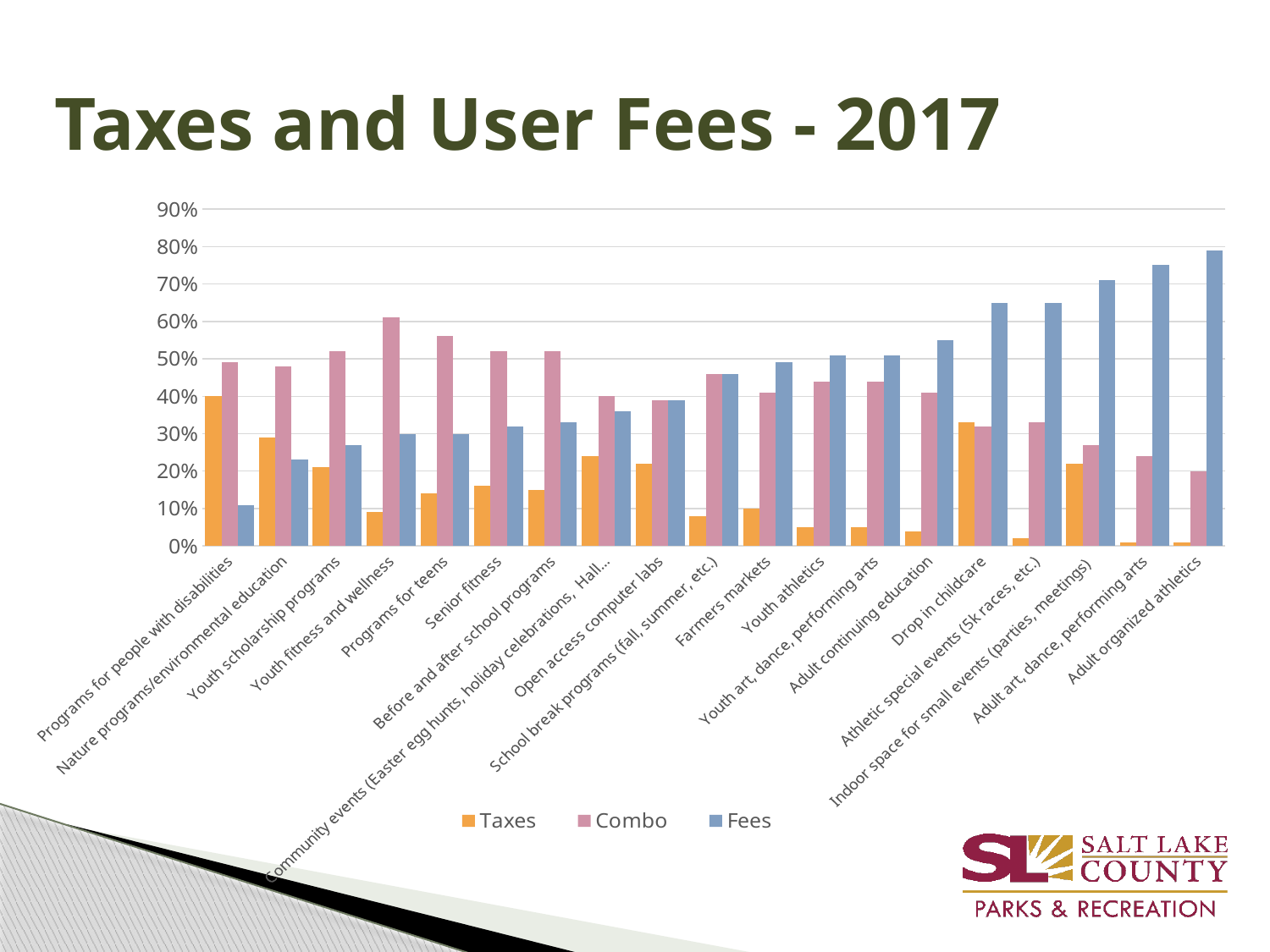
What kind of chart is shown on the slide? Bar chart How many program categories are shown along the x axis? 19 Which category has the lowest Fees value? Programs for people with disabilities Which category has the highest Taxes value? Programs for people with disabilities Is the Combo value for Youth fitness and wellness greater or less than 50%? greater Is the Fees value for Adult organized athletics greater or less than 70%? greater Do the Fees values generally rise or fall moving from left to right along the x axis? Rise How many series does the legend list? 3 What is the title of the chart? Taxes and User Fees - 2017 Which category has the highest Fees value? Adult organized athletics For Programs for teens, which is larger: the Combo value or the Fees value? Combo Which category has the highest Combo value? Youth fitness and wellness